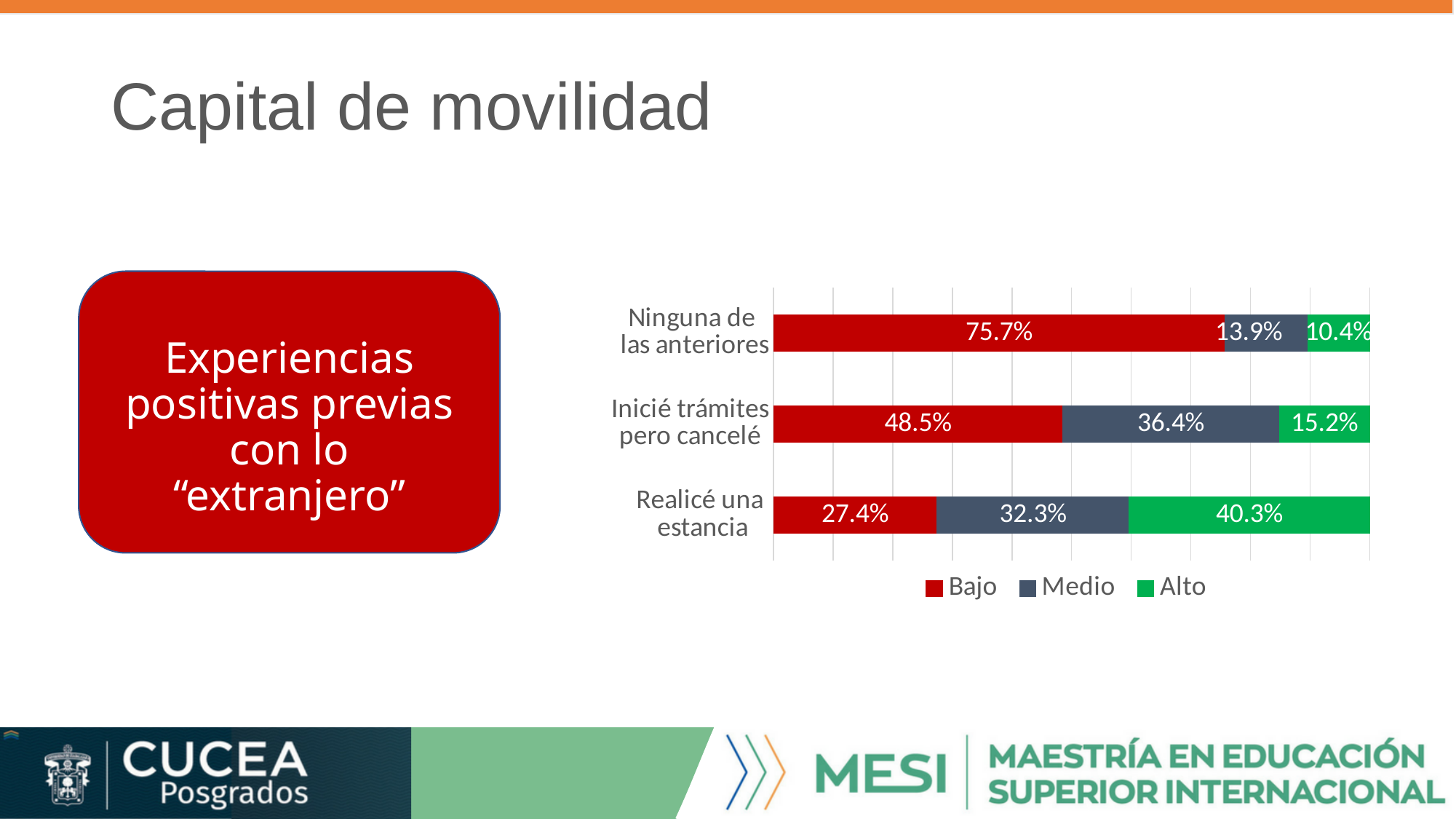
What is the difference between the Bajo values for "Ninguna de las anteriores" and "Realicé una estancia"? 48.3% Which colour represents the Alto series in the chart? Green What is the Alto value for "Realicé una estancia"? 40.3% What kind of chart is shown on the slide? Stacked bar chart Which category has the highest Bajo value? Ninguna de las anteriores How many categories are shown on the chart? 3 What is the Medio value for "Inicié trámites pero cancelé"? 36.4% What is the Bajo value for "Ninguna de las anteriores"? 75.7% Which is larger for "Realicé una estancia": the Medio value or the Alto value? Alto Which category has the lowest Alto value? Ninguna de las anteriores How many series does the legend list? 3 What is the Alto value for "Ninguna de las anteriores"? 10.4%